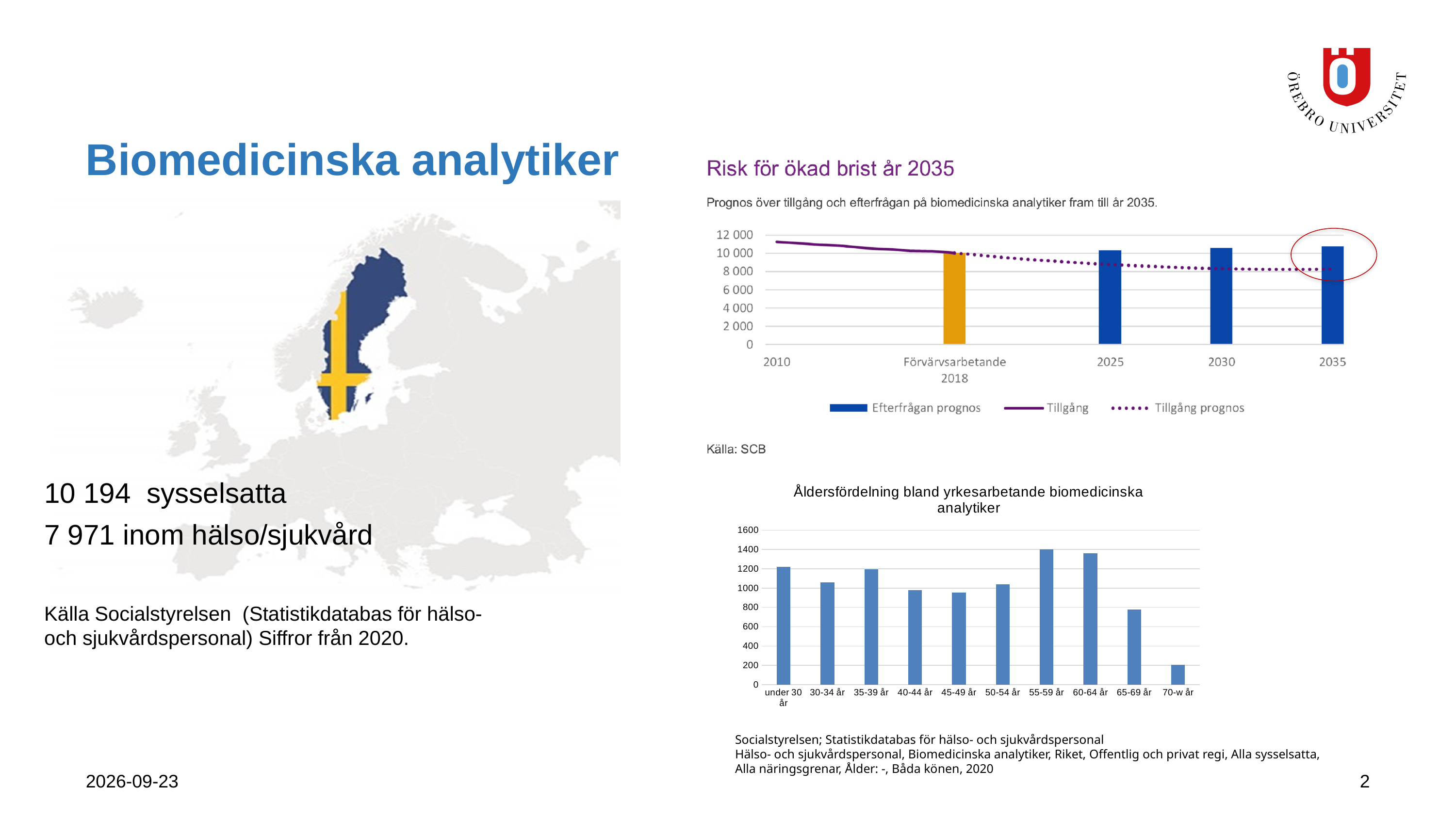
How many series does the legend of the 'Risk för ökad brist år 2035' chart list? 3 In the 'Åldersfördelning bland yrkesarbetande biomedicinska analytiker' chart, which is larger: the value for 60-64 år or for 65-69 år? 60-64 år In the 'Åldersfördelning bland yrkesarbetande biomedicinska analytiker' chart, which age group has the lowest value? 70-w år In the 'Åldersfördelning bland yrkesarbetande biomedicinska analytiker' chart, is the value for 55-59 år greater or less than 1200? greater In the 'Åldersfördelning bland yrkesarbetande biomedicinska analytiker' chart, which age group has the highest value? 55-59 år In the 'Åldersfördelning bland yrkesarbetande biomedicinska analytiker' chart, is the value for 45-49 år greater or less than 1000? less In the 'Risk för ökad brist år 2035' chart, is the Efterfrågan prognos bar for 2035 greater or less than 10 000? greater What type of chart is the 'Åldersfördelning bland yrkesarbetande biomedicinska analytiker' chart? bar chart In the 'Åldersfördelning bland yrkesarbetande biomedicinska analytiker' chart, which is larger: the value for under 30 år or for 30-34 år? under 30 år How many age categories are shown in the 'Åldersfördelning bland yrkesarbetande biomedicinska analytiker' chart? 10 In the 'Risk för ökad brist år 2035' chart, does the Tillgång prognos line rise or fall from 2018 to 2035? fall